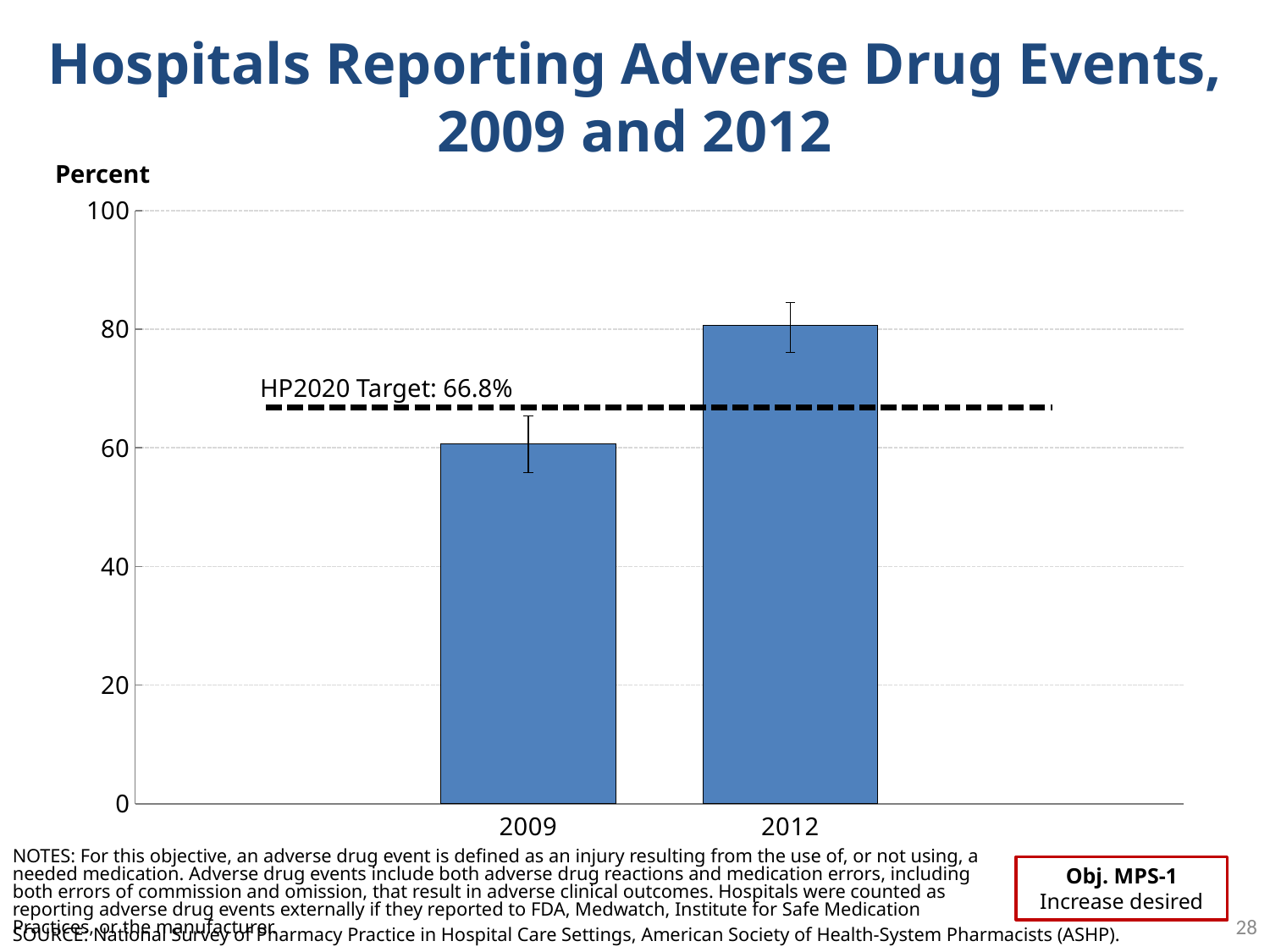
Is the value for 2009 greater or less than 80? less What is the label on the vertical axis of the chart? Percent What is the HP2020 Target value shown by the dashed line? 66.8% Is the value for 2012 greater or less than 60? greater Which year has the higher percentage of hospitals reporting adverse drug events? 2012 How many years (bars) are plotted in the chart? 2 What kind of chart is shown on the slide? Bar chart Is the value for 2012 larger or smaller than the value for 2009? Larger Is the value for 2009 greater or less than 40? greater Which year has the lower percentage of hospitals reporting adverse drug events? 2009 Does the percentage of hospitals reporting adverse drug events rise or fall from 2009 to 2012? Rise